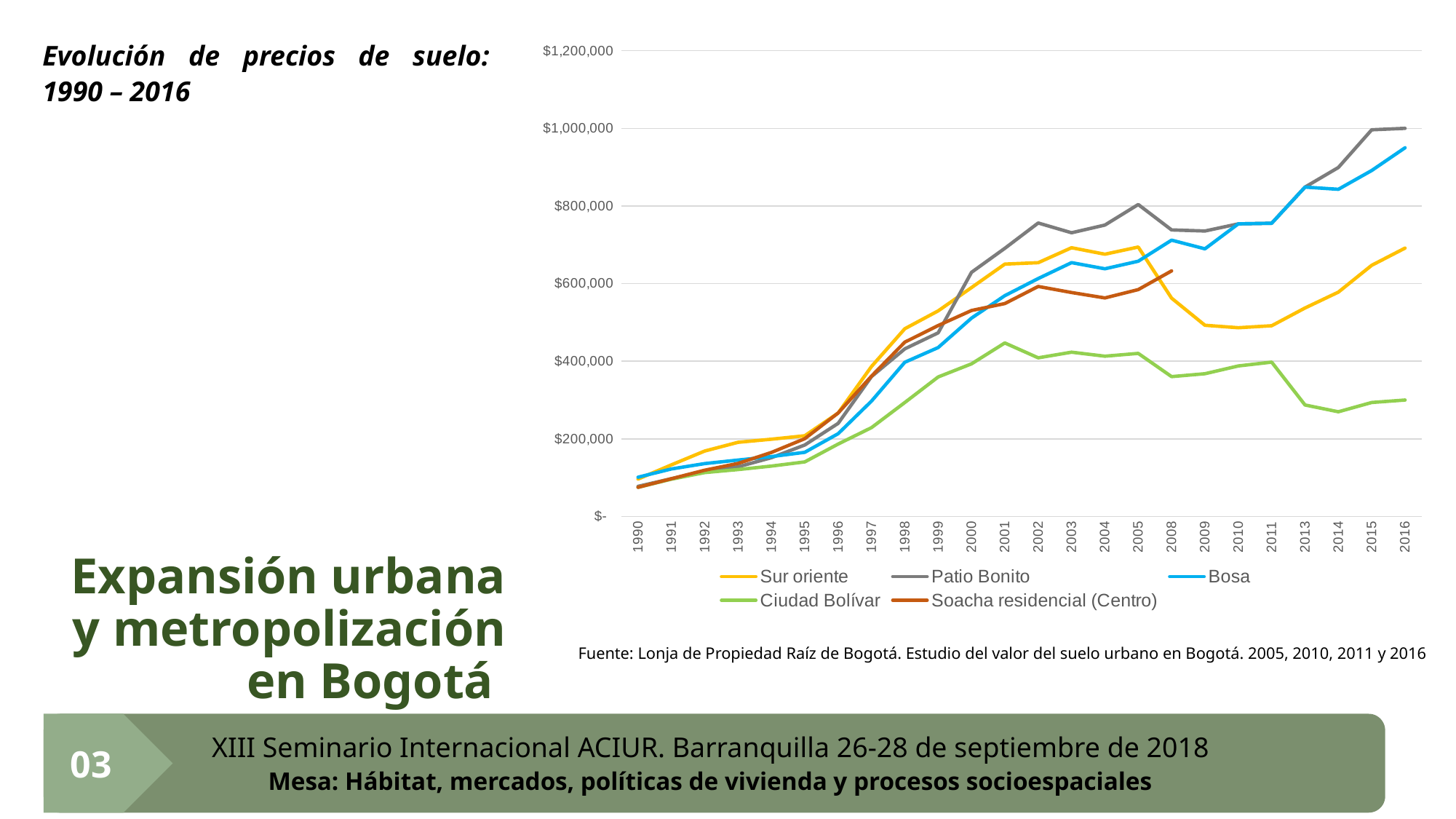
Is the value for Sur oriente in 2010 greater or less than $600,000? less What kind of chart is shown on the slide? Line chart How many years are shown on the x axis? 24 How many series does the legend list? 5 In 2010, which is larger: the value for Bosa or the value for Sur oriente? Bosa Is the value for Bosa in 2016 greater or less than $800,000? greater Which series has the lowest value in 2016? Ciudad Bolívar Which series stops at 2008 and has no values after that year? Soacha residencial (Centro) Is the value for Ciudad Bolívar in 2016 greater or less than $400,000? less Which series has the highest value in 2016? Patio Bonito Does the Bosa series generally rise or fall from 1990 to 2016? Rise What colour is the line for Sur oriente? Yellow